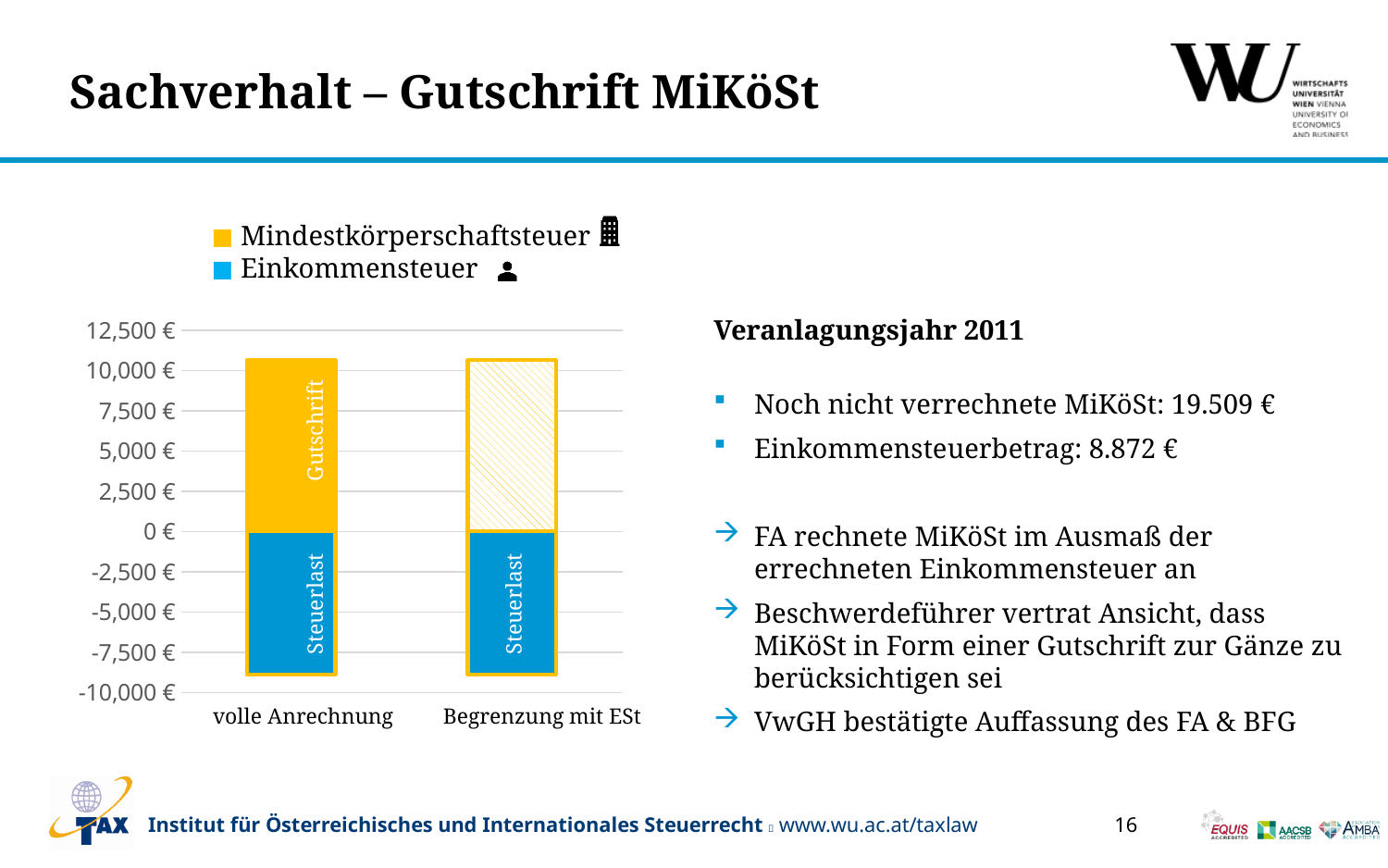
Is the Einkommensteuer value for 'volle Anrechnung' greater or less than -7,500 €? less What is the lowest value shown on the y axis of the chart? -10,000 € Is the Einkommensteuer value for 'Begrenzung mit ESt' greater or less than -10,000 €? greater How many categories are shown on the x axis of the chart? 2 What is the highest value shown on the y axis of the chart? 12,500 € Is the Mindestkörperschaftsteuer value for 'volle Anrechnung' greater or less than 10,000 €? greater Which series is shown in blue in the chart? Einkommensteuer What is the label of the second category on the x axis of the chart? Begrenzung mit ESt What kind of chart is shown on the slide? stacked bar chart Which series is shown in yellow in the chart? Mindestkörperschaftsteuer How many series does the chart legend list? 2